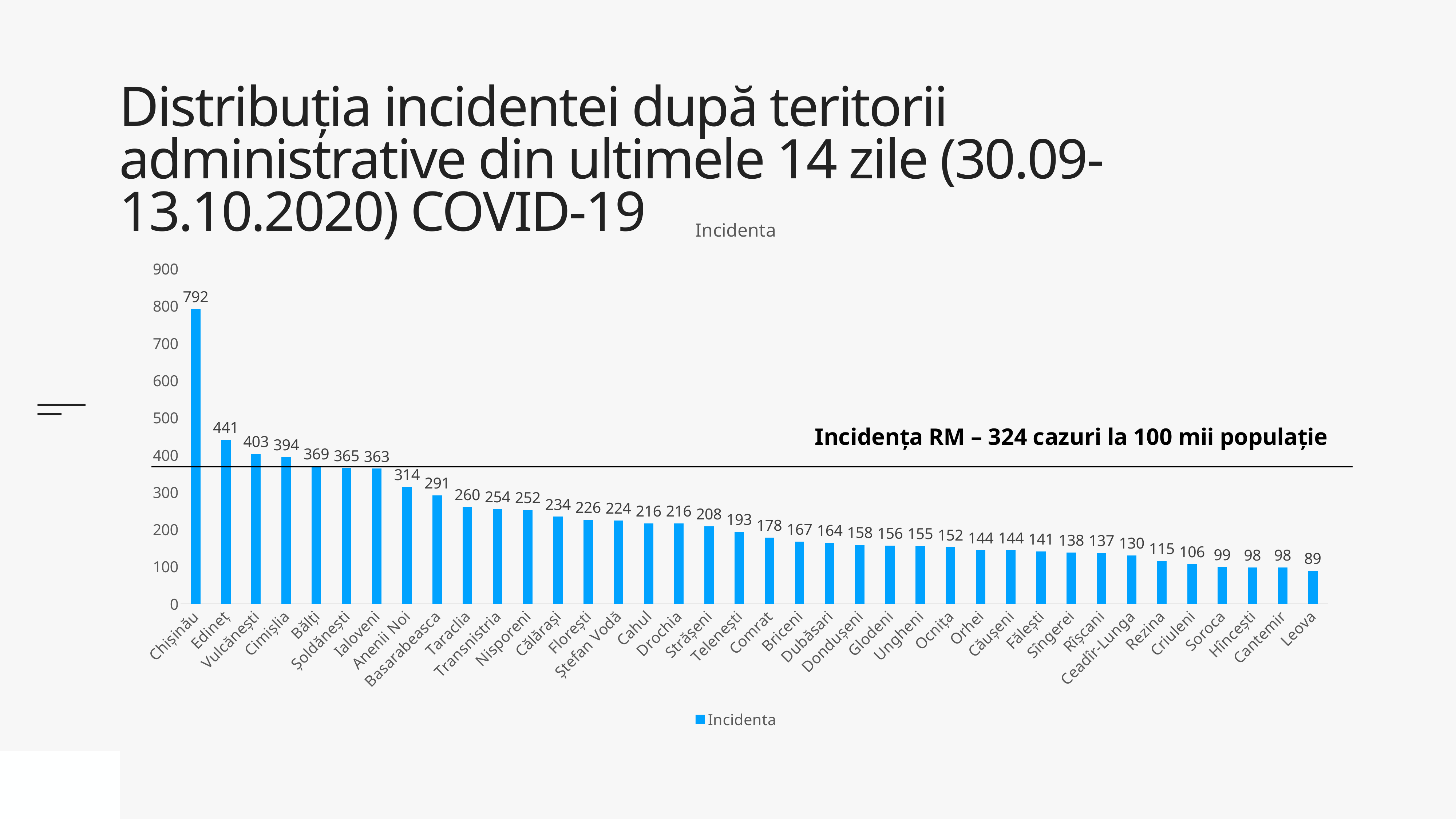
What kind of chart is shown on the slide? Bar chart What is the national incidence (Incidența RM) stated on the chart? 324 cazuri la 100 mii populație Which has a higher incidence, Taraclia or Nisporeni? Taraclia Which territory has the lowest incidence? Leova How many territories are shown on the x axis? 38 What is the difference between the incidence values for Chișinău and Edineț? 351 What is the incidence value for Chișinău? 792 Which territory has the highest incidence? Chișinău How many series does the legend list? 1 What is the incidence value for Bălți? 369 What is the incidence value for Cahul? 216 What is the incidence value for Orhei? 144